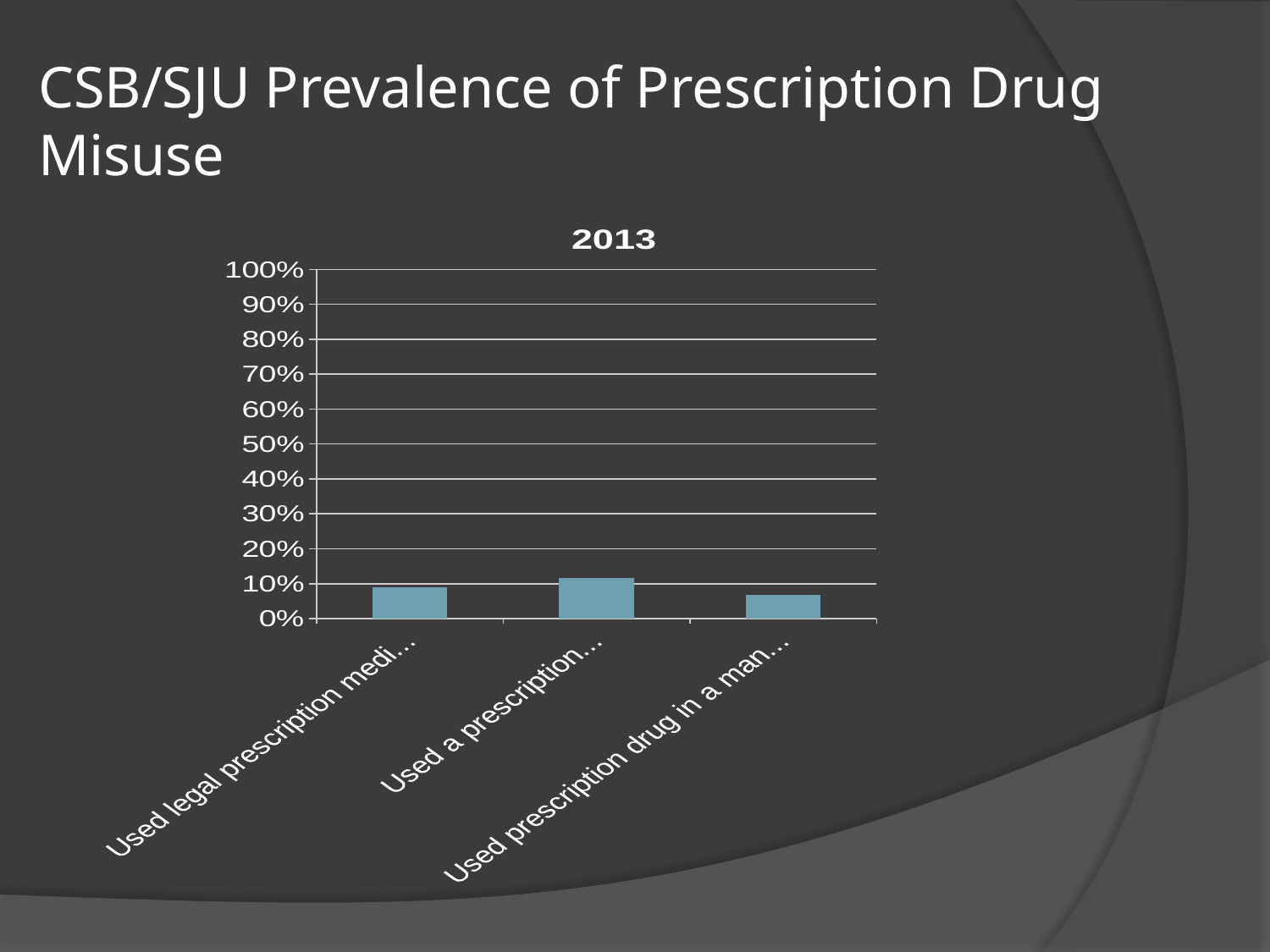
Which is larger: the value for the middle bar (Used a prescription…) or the third bar (Used prescription drug in a man…)? Used a prescription… (the middle bar) Which is larger: the value for the first bar (Used legal prescription medi…) or the third bar (Used prescription drug in a man…)? Used legal prescription medi… (the first bar) Is the value for the third bar (Used prescription drug in a man…) greater or less than 10%? less Which category has the lowest bar? Used prescription drug in a man… (the third bar) How many bars (categories) does the chart show? 3 What is the maximum value shown on the vertical axis? 100% What is the title of the chart? 2013 Is the value for the middle bar (Used a prescription…) greater or less than 20%? less Is the value for the middle bar (Used a prescription…) greater or less than 10%? greater What kind of chart is shown on the slide? bar chart Which category has the highest bar? Used a prescription… (the middle bar)